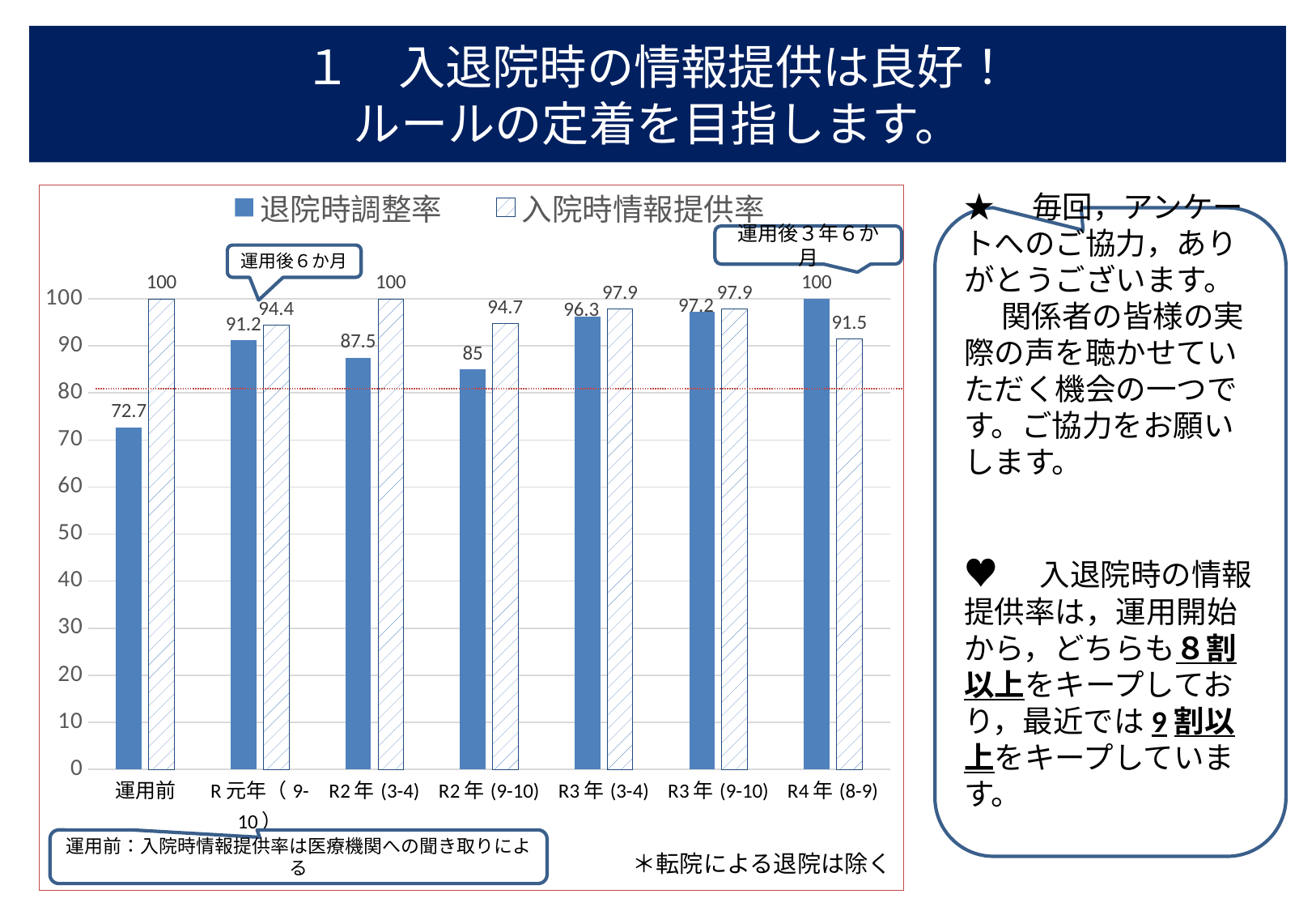
What is the 入院時情報提供率 value for R2年(9-10)? 94.7 Which category has the highest 退院時調整率 value? R4年(8-9) What is the 退院時調整率 value for 運用前? 72.7 What is the difference between the 退院時調整率 values for R3年(3-4) and R2年(3-4)? 8.8 Which category has the lowest 退院時調整率 value? 運用前 For R4年(8-9), which is larger: 退院時調整率 or 入院時情報提供率? 退院時調整率 How many series does the legend list? 2 Is the 退院時調整率 value for R2年(9-10) greater or less than 80? greater What kind of chart is shown on the slide? bar chart What is the difference between the 入院時情報提供率 and 退院時調整率 values for 運用前? 27.3 How many categories are shown on the x axis? 7 What is the 退院時調整率 value for R3年(9-10)? 97.2